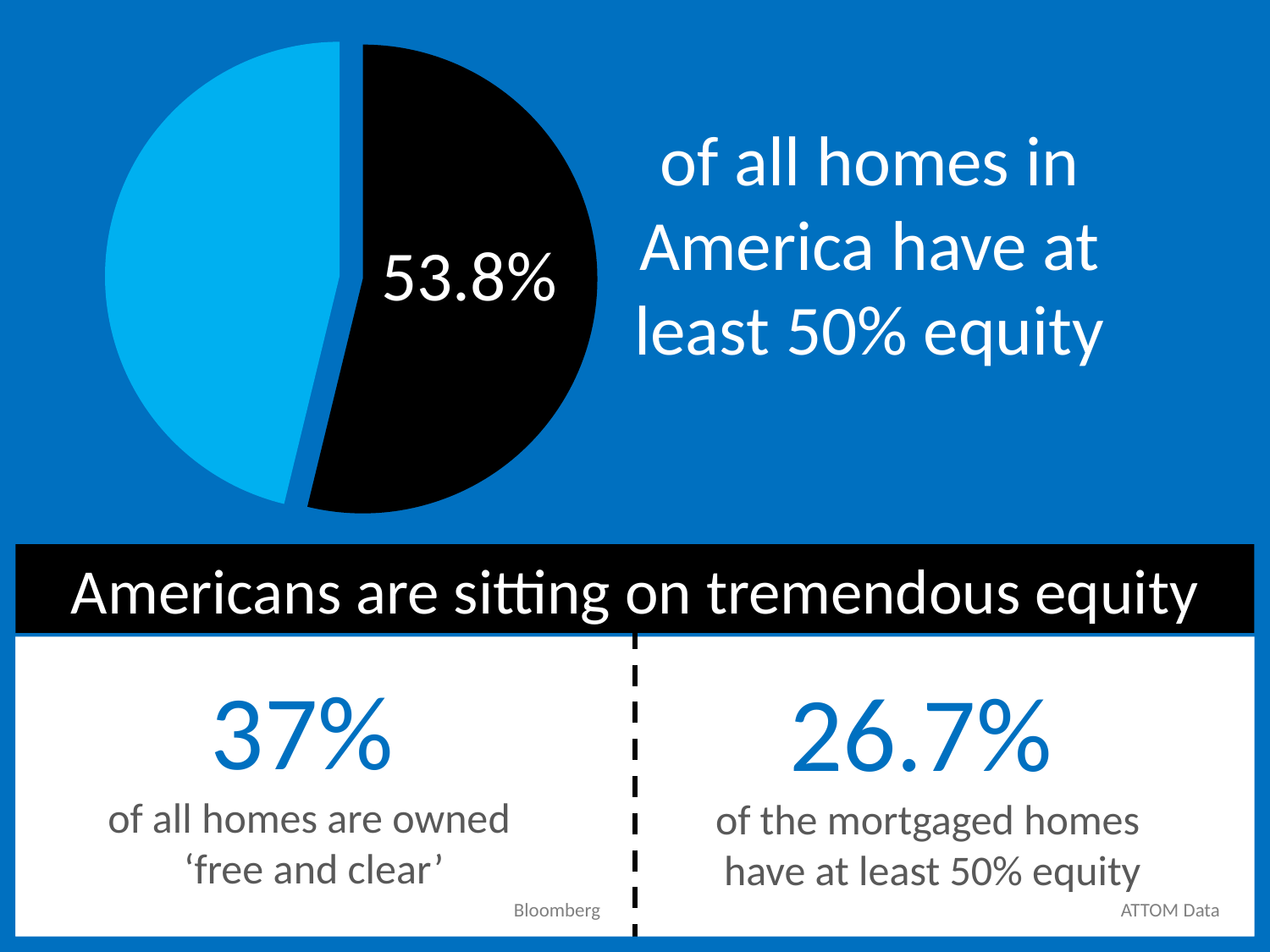
What colour is the slice of the pie chart that carries the 53.8% label? black Which slice of the pie chart is larger, the black slice or the light blue slice? black What kind of chart is shown on the slide? pie chart What value is printed on the black slice of the pie chart? 53.8% How many slices does the pie chart have? 2 Is the black slice of the pie chart greater or less than 50% of the pie? greater What share of the pie does the black slice represent? 53.8% According to the text next to the pie chart, what does the 53.8% slice represent? homes in America with at least 50% equity